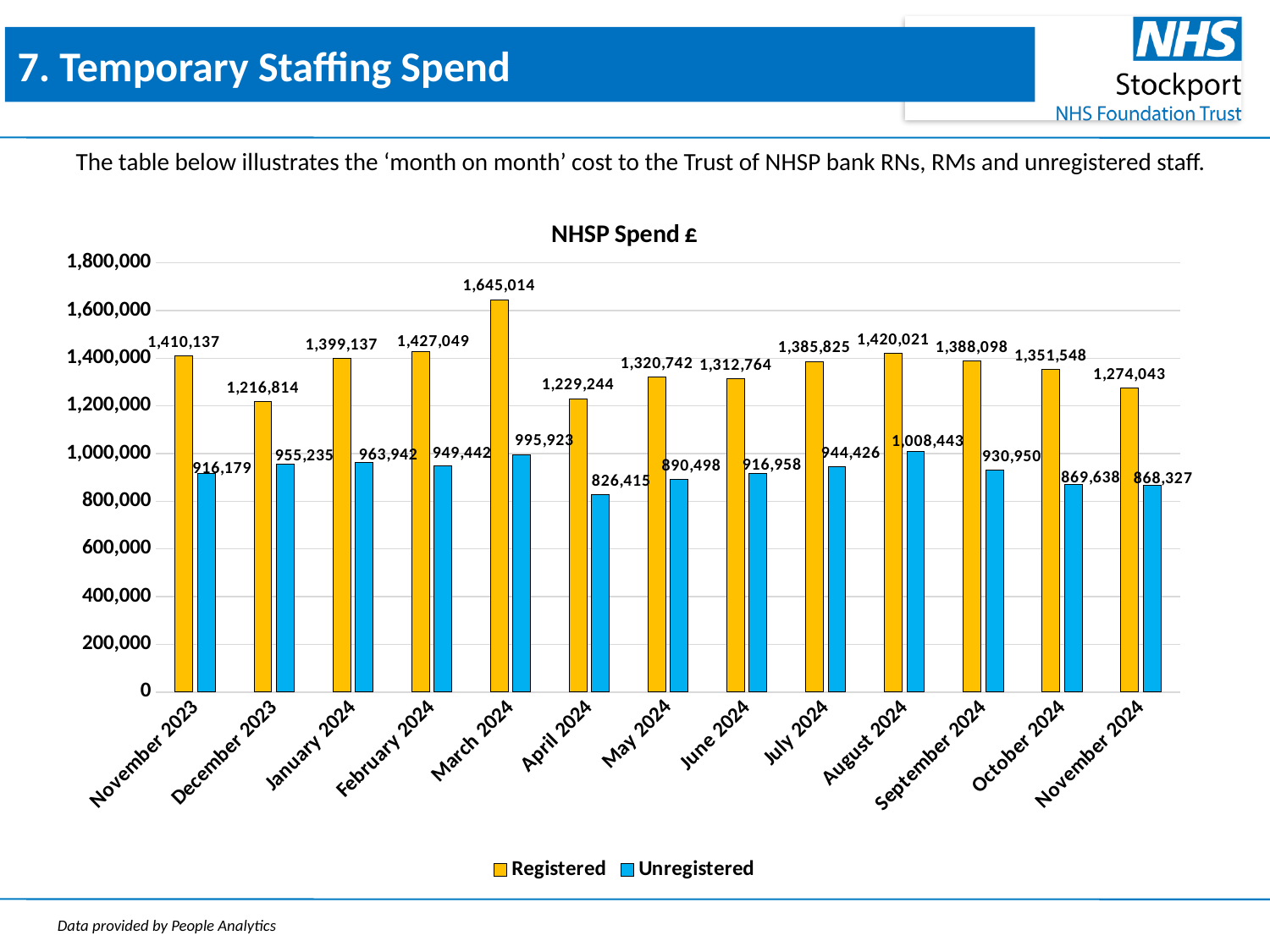
What is the Registered NHSP spend for November 2024? 1,274,043 What is the difference between the Registered and Unregistered spend in March 2024? 649,091 Which month has the highest Registered spend? March 2024 Which month has the lowest Unregistered spend? April 2024 Which is larger, the Unregistered spend in August 2024 or in April 2024? August 2024 Which month has the highest Unregistered spend? August 2024 What type of chart is shown on the slide? Bar chart How many series does the legend list? 2 Is the Unregistered spend for August 2024 greater or less than 1,000,000? greater How many months are shown on the x axis? 13 What is the Registered NHSP spend for March 2024? 1,645,014 What is the Unregistered NHSP spend for April 2024? 826,415